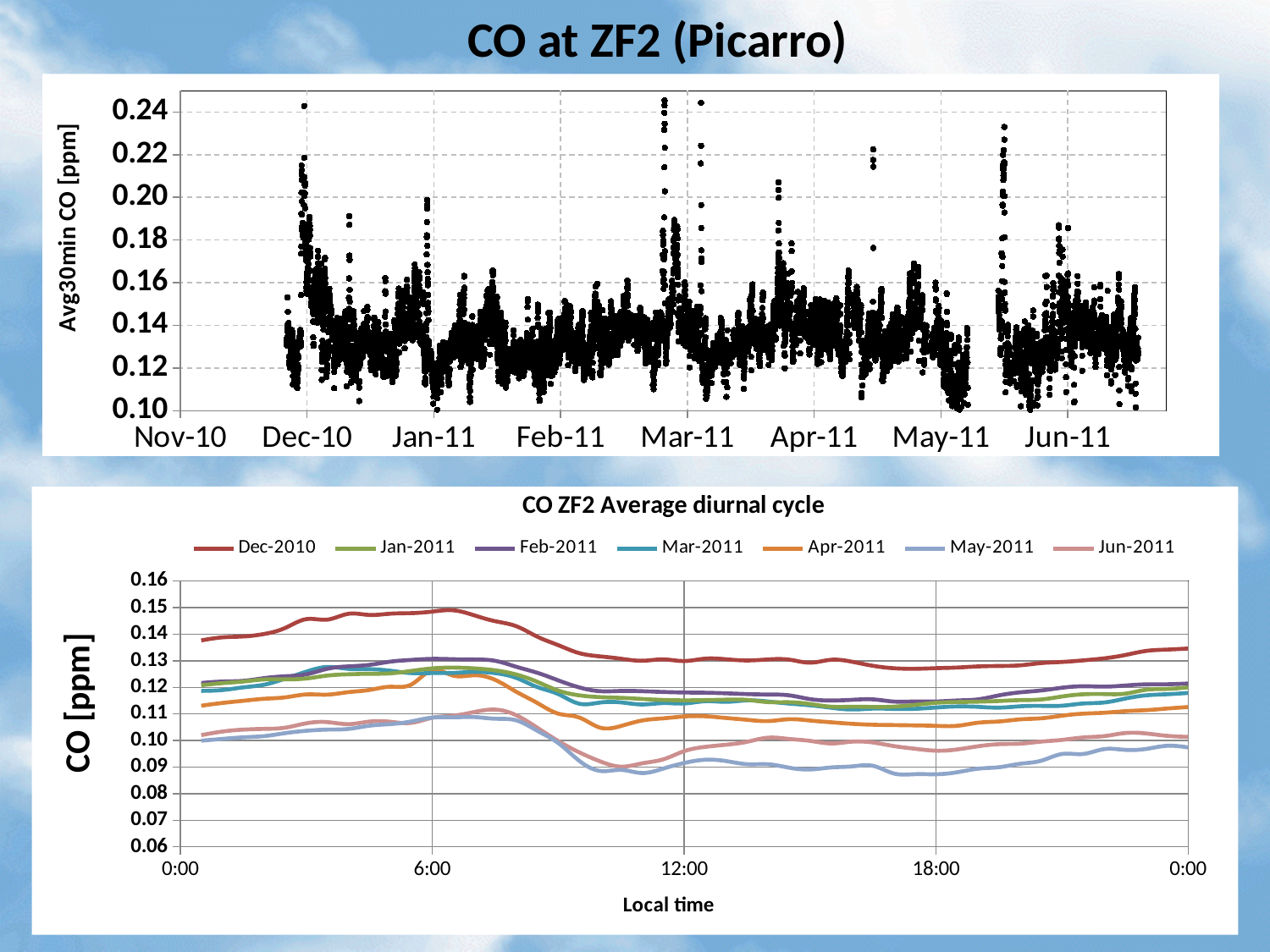
How many series does the legend of the 'CO ZF2 Average diurnal cycle' chart list? 7 In the 'CO ZF2 Average diurnal cycle' chart, which month's series has the lowest values throughout the day? May-2011 What kind of chart is the bottom chart, 'CO ZF2 Average diurnal cycle'? line chart In the 'CO ZF2 Average diurnal cycle' chart, which month's series has the highest values throughout the day? Dec-2010 In the 'CO ZF2 Average diurnal cycle' chart, does the Dec-2010 series rise or fall between 6:00 and 12:00? fall In the top chart, is the highest data point near Dec-10 greater or less than 0.22? greater What is the x-axis title of the 'CO ZF2 Average diurnal cycle' chart? Local time In the 'CO ZF2 Average diurnal cycle' chart, which is larger at 12:00: the Dec-2010 value or the May-2011 value? Dec-2010 In the 'CO ZF2 Average diurnal cycle' chart, is the May-2011 value at 12:00 greater or less than 0.10? less What kind of chart is the top chart on the slide? scatter plot In the 'CO ZF2 Average diurnal cycle' chart, is the Dec-2010 value at 6:00 greater or less than 0.14? greater What is the y-axis label of the top chart on the slide? Avg30min CO [ppm]